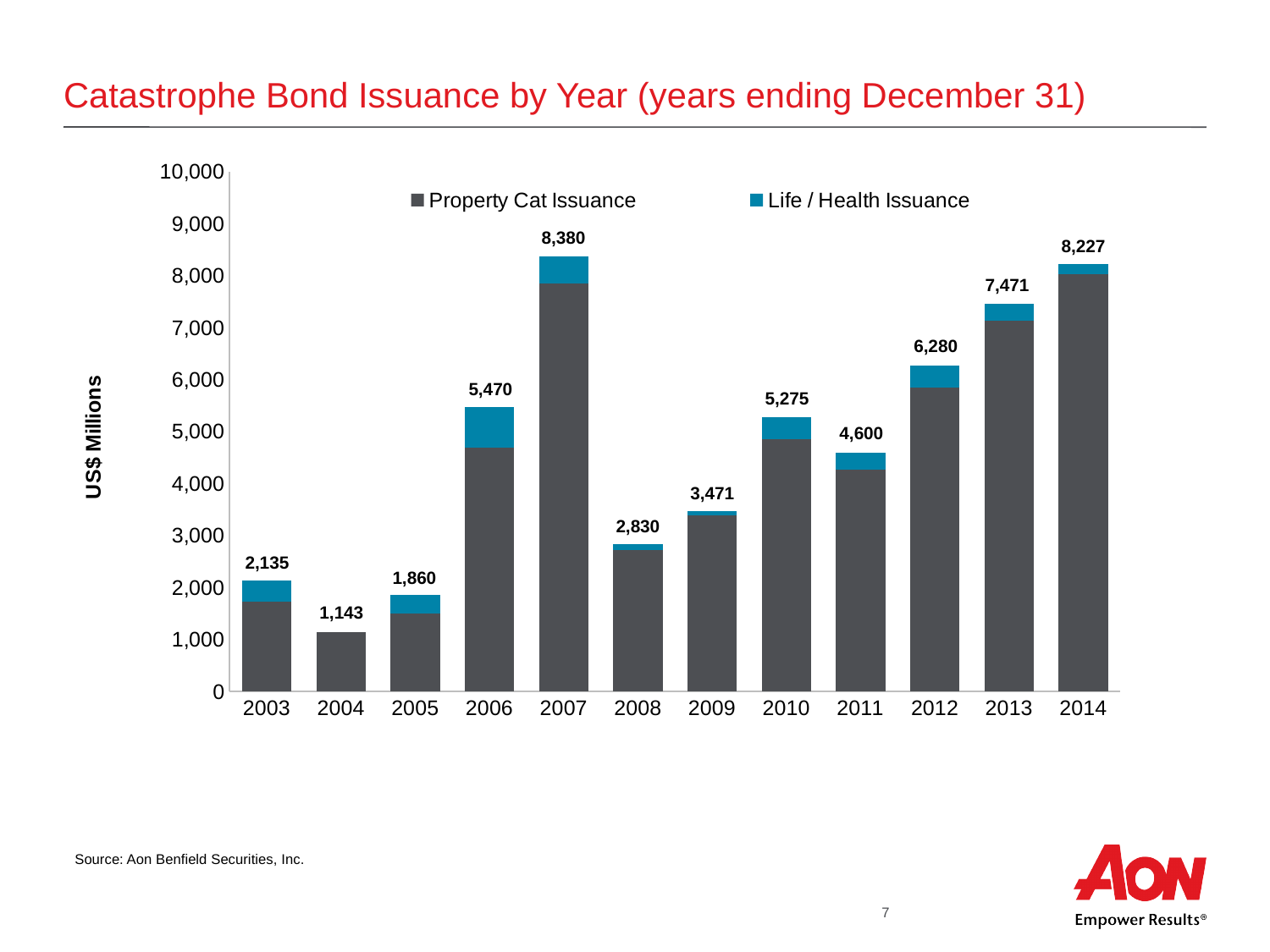
What is the total catastrophe bond issuance shown for 2011? 4,600 Is the Property Cat Issuance for 2006 greater or less than 5,000? less Which year has the highest total catastrophe bond issuance? 2007 What is the difference between the total issuance in 2007 and in 2008? 5,550 What is the total catastrophe bond issuance shown for 2004? 1,143 Which year has the lowest total catastrophe bond issuance? 2004 What kind of chart is shown on the slide? Stacked bar chart How many series does the legend list? 2 What is the difference between the total issuance in 2014 and in 2013? 756 How many years are shown on the x axis? 12 What is the total catastrophe bond issuance shown for 2007? 8,380 Which year had a larger total issuance, 2010 or 2012? 2012